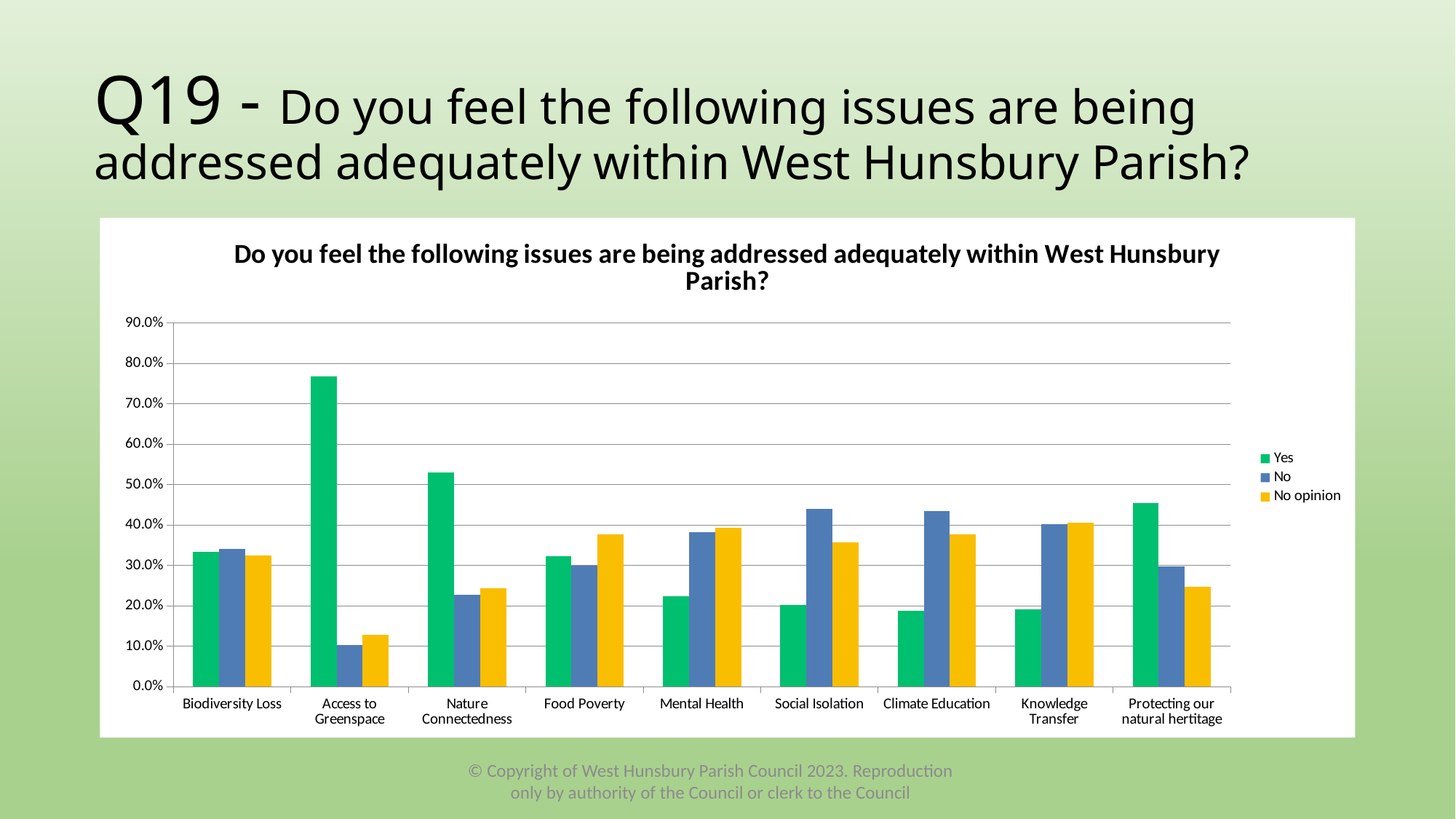
How many issue categories are shown on the x axis? 9 For Nature Connectedness, which is larger: the 'Yes' value or the 'No opinion' value? Yes What kind of chart is shown on the slide? Bar chart What colour represents the 'Yes' series in the legend? Green Which issue has the lowest 'No' value? Access to Greenspace Is the 'Yes' value for Mental Health greater or less than 30.0%? less Is the 'No' value for Access to Greenspace greater or less than 20.0%? less How many series does the legend list? 3 For Social Isolation, which is larger: the 'Yes' value or the 'No' value? No Which issue has the highest 'Yes' value? Access to Greenspace Is the 'Yes' value for Nature Connectedness greater or less than 50.0%? greater